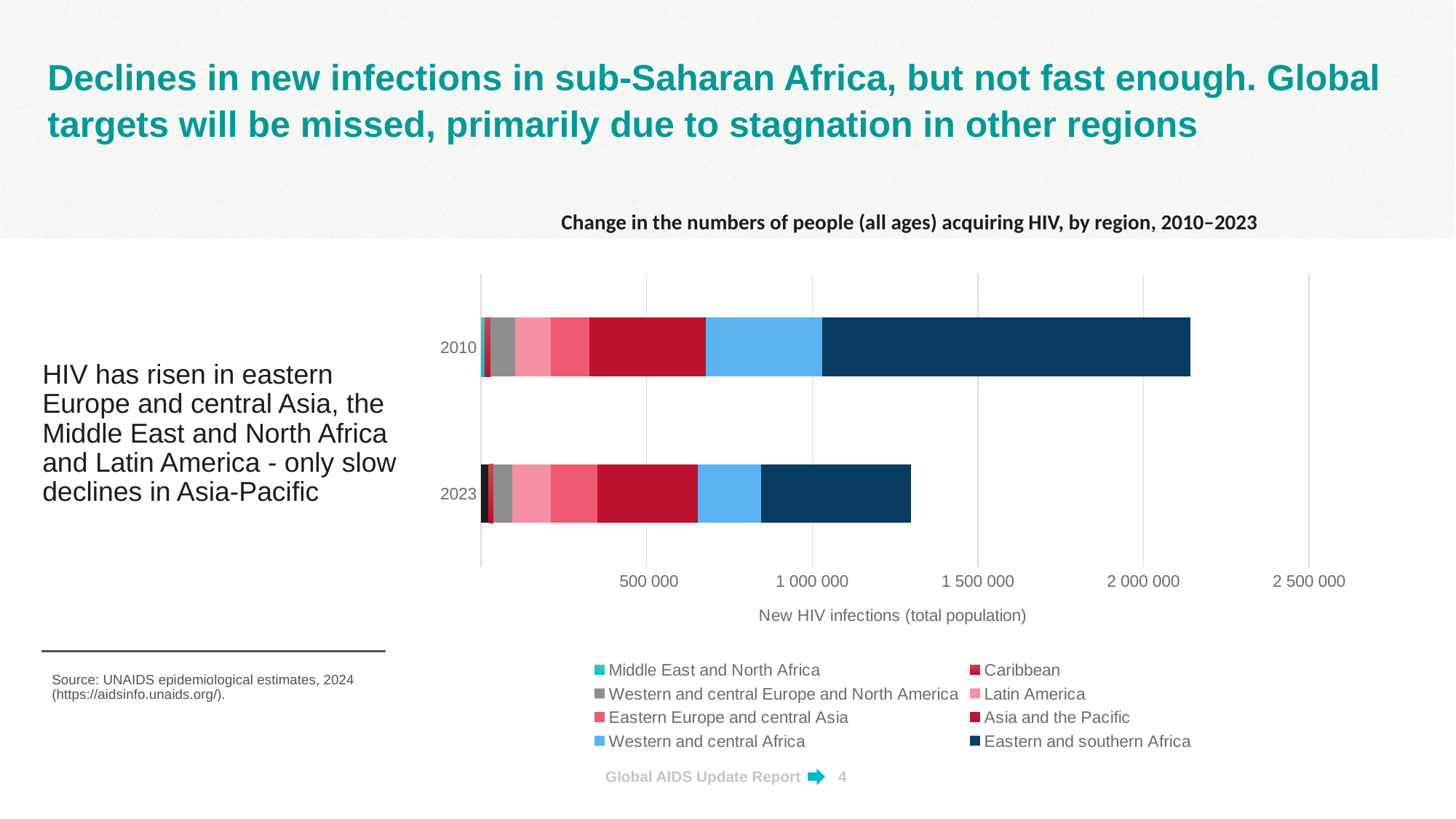
Is the total bar for 2010 greater or less than 2 000 000? greater Which year has the longer total bar, 2010 or 2023? 2010 Do total new HIV infections rise or fall from 2010 to 2023? Fall How many years (bars) are plotted in the chart? 2 What is the label of the horizontal axis? New HIV infections (total population) Is the total bar for 2023 greater or less than 1 000 000? greater Is the total bar for 2023 greater or less than 1 500 000? less Is the Eastern and southern Africa segment larger in 2010 or in 2023? 2010 What kind of chart is shown on the slide? Stacked bar chart How many series does the chart legend list? 8 Which region has the largest segment in the 2010 bar? Eastern and southern Africa What is the title of the chart? Change in the numbers of people (all ages) acquiring HIV, by region, 2010–2023